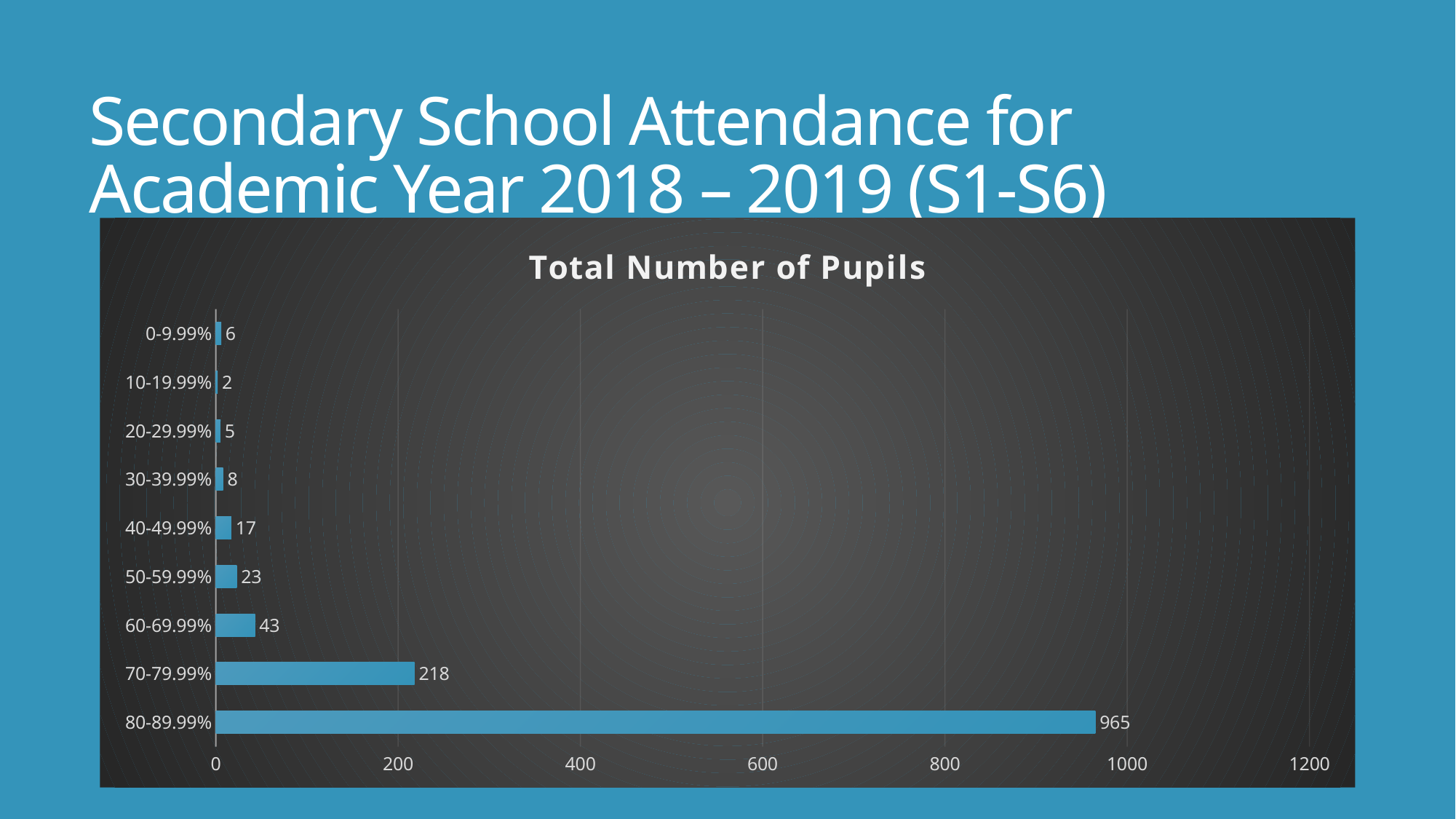
What is the total number of pupils in the 40-49.99% attendance band? 17 Which attendance band has the lowest number of pupils? 10-19.99% How many attendance bands are shown on the chart? 9 What is the difference in pupil numbers between the 60-69.99% band and the 50-59.99% band? 20 What is the difference in pupil numbers between the 80-89.99% band and the 70-79.99% band? 747 Which has more pupils, the 30-39.99% band or the 20-29.99% band? 30-39.99% Which attendance band has the highest number of pupils? 80-89.99% Is the value for the 80-89.99% band greater or less than 800? greater What kind of chart is shown on the slide? Bar chart What is the total number of pupils in the 80-89.99% attendance band? 965 What is the total number of pupils in the 70-79.99% attendance band? 218 What is the title of the chart? Total Number of Pupils